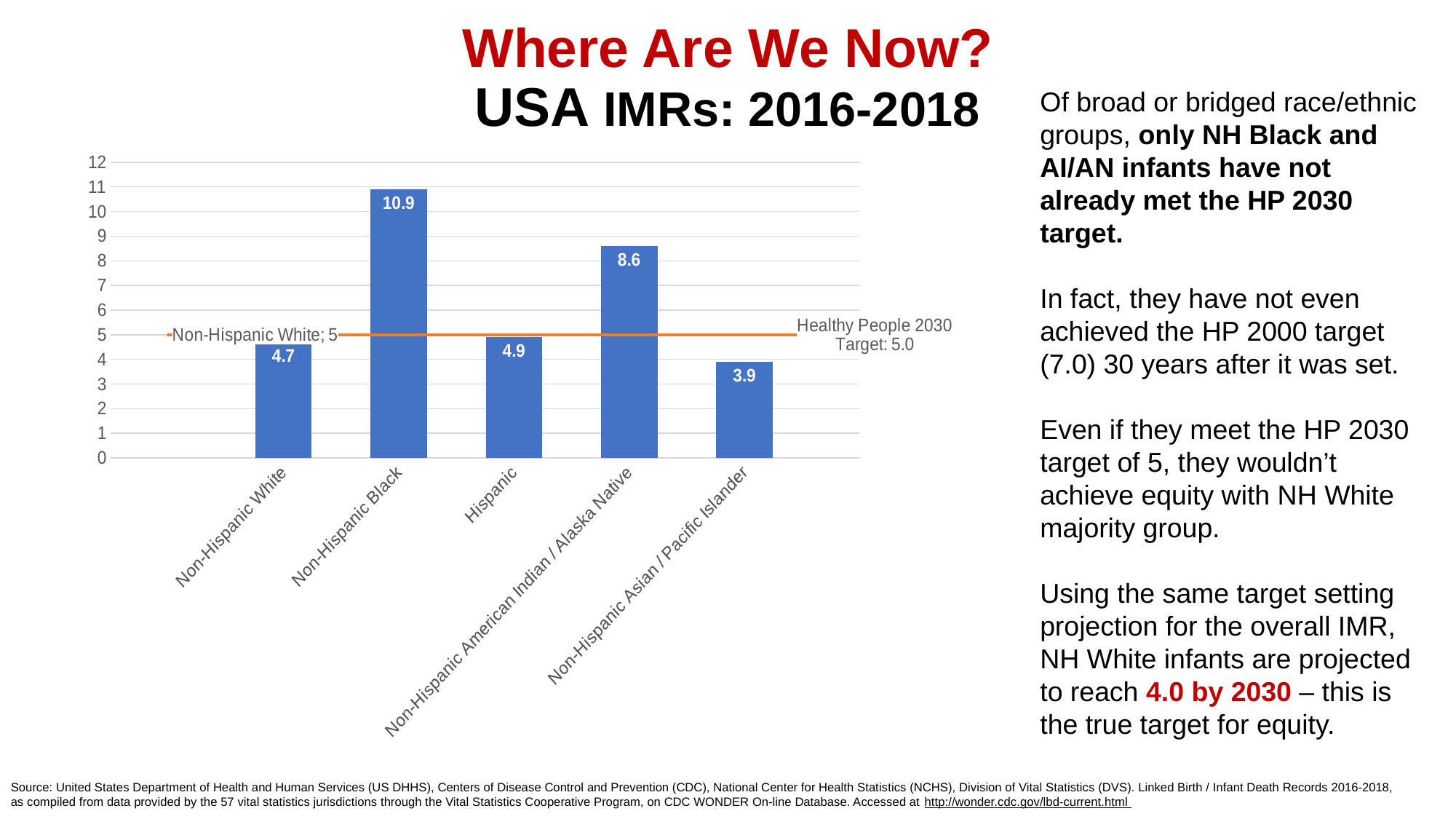
What target value does the horizontal orange line represent? 5.0 What kind of chart is shown on the slide? Bar chart What is the IMR value for Hispanic? 4.9 What is the IMR value for Non-Hispanic Black? 10.9 What is the difference between the IMR for Non-Hispanic Black and Non-Hispanic White? 6.2 Which is larger, the IMR for Non-Hispanic American Indian / Alaska Native or for Hispanic? Non-Hispanic American Indian / Alaska Native Which race/ethnic group has the lowest IMR? Non-Hispanic Asian / Pacific Islander How many race/ethnic groups are shown as bars in the chart? 5 Which race/ethnic group has the highest IMR? Non-Hispanic Black Is the value for Non-Hispanic Black greater or less than 10? greater What is the difference between the IMR for Non-Hispanic American Indian / Alaska Native and Hispanic? 3.7 What is the IMR value for Non-Hispanic Asian / Pacific Islander? 3.9